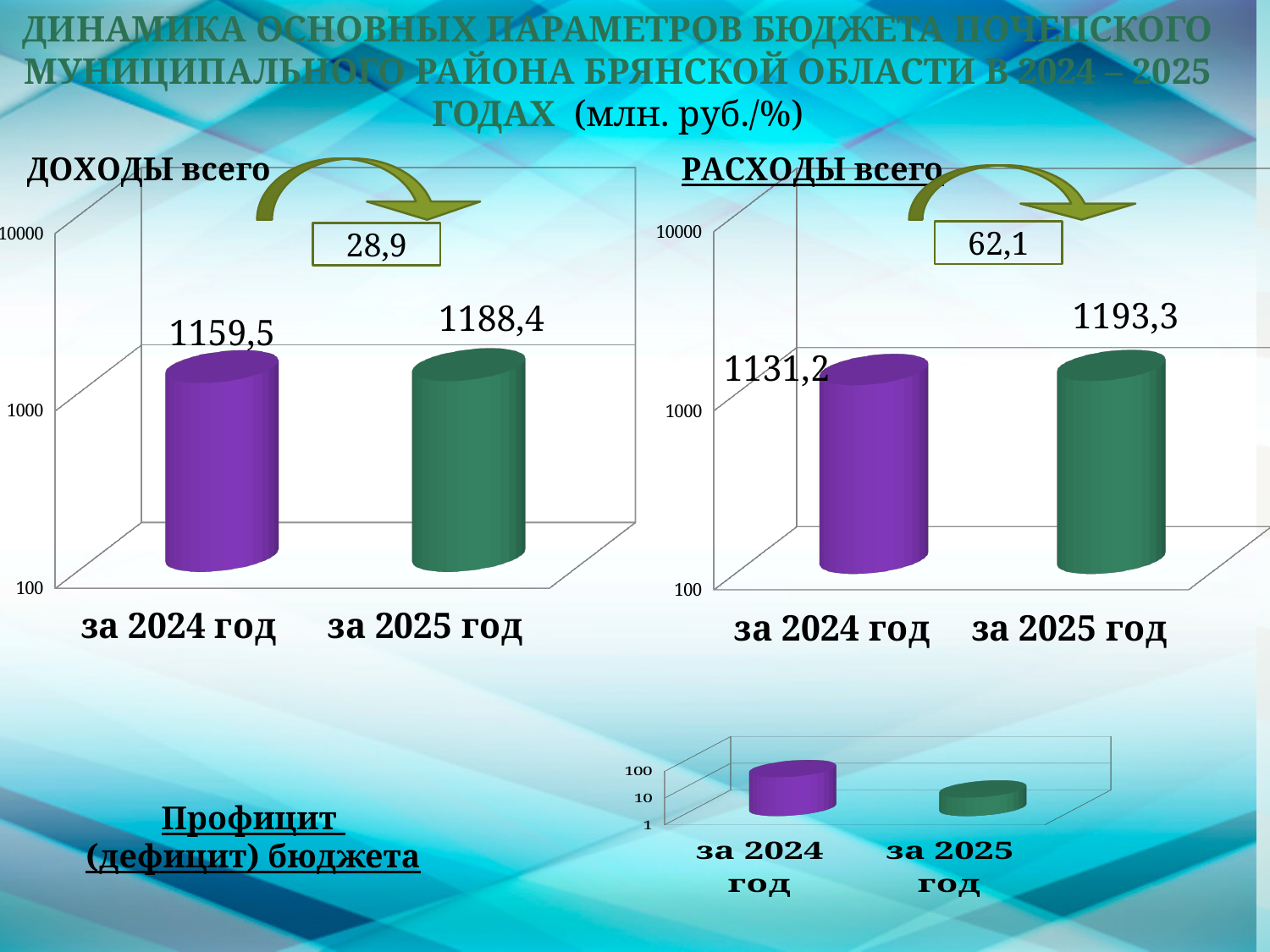
On the РАСХОДЫ всего chart, what is the value for за 2025 год? 1193,3 How many categories are shown on the ДОХОДЫ всего chart? 2 What kind of chart is the РАСХОДЫ всего chart? Bar chart On the ДОХОДЫ всего chart, do the values rise or fall from за 2024 год to за 2025 год? Rise On the ДОХОДЫ всего chart, which year has the lower value? за 2024 год On the Профицит (дефицит) бюджета chart, which bar is taller, за 2024 год or за 2025 год? за 2024 год On the РАСХОДЫ всего chart, what is the value for за 2024 год? 1131,2 On the ДОХОДЫ всего chart, what is the difference between the values for за 2025 год and за 2024 год? 28,9 On the ДОХОДЫ всего chart, what is the value for за 2025 год? 1188,4 On the РАСХОДЫ всего chart, which year has the higher value? за 2025 год On the ДОХОДЫ всего chart, what is the value for за 2024 год? 1159,5 On the РАСХОДЫ всего chart, what is the difference between the values for за 2025 год and за 2024 год? 62,1